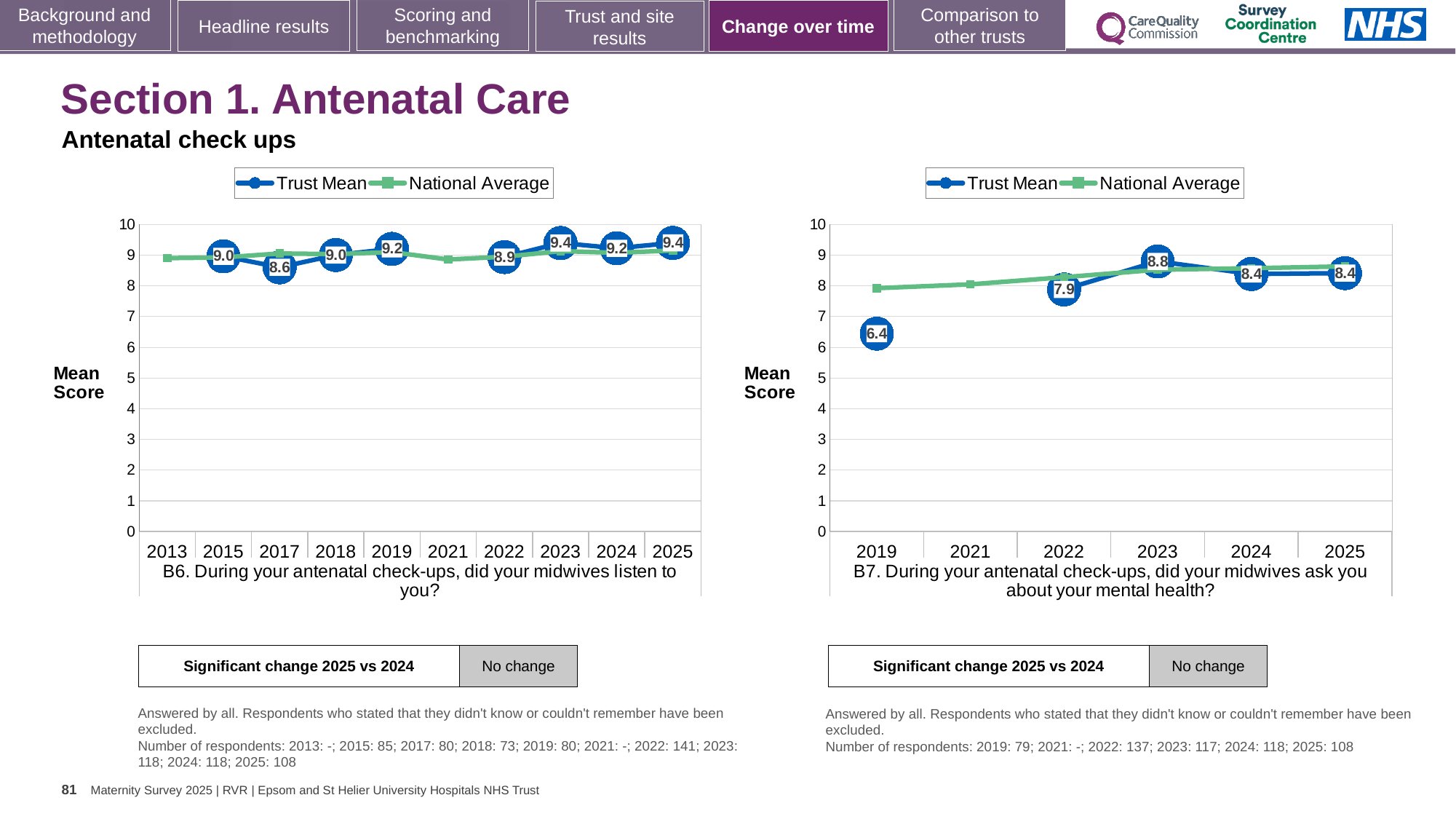
In the B6 chart (left), which year has the lowest Trust Mean score? 2017 In the B7 chart (right), is the National Average value for 2019 greater or less than 7? greater How many series does the legend of the B6 chart (left) list? 2 In the B7 chart (right), what is the Trust Mean score for 2023? 8.8 In the B6 chart (left), what is the Trust Mean score for 2025? 9.4 In the B7 chart (right), which year has the lowest Trust Mean score? 2019 In the B6 chart (left), which is larger, the Trust Mean score for 2023 or for 2024? 2023 In the B6 chart (left), what is the Trust Mean score for 2017? 8.6 How many years are shown on the x axis of the B7 chart (right)? 6 In the B7 chart (right), what is the difference between the Trust Mean scores for 2023 and 2019? 2.4 What kind of chart is the B6 chart (left)? Line chart In the B7 chart (right), what is the Trust Mean score for 2019? 6.4